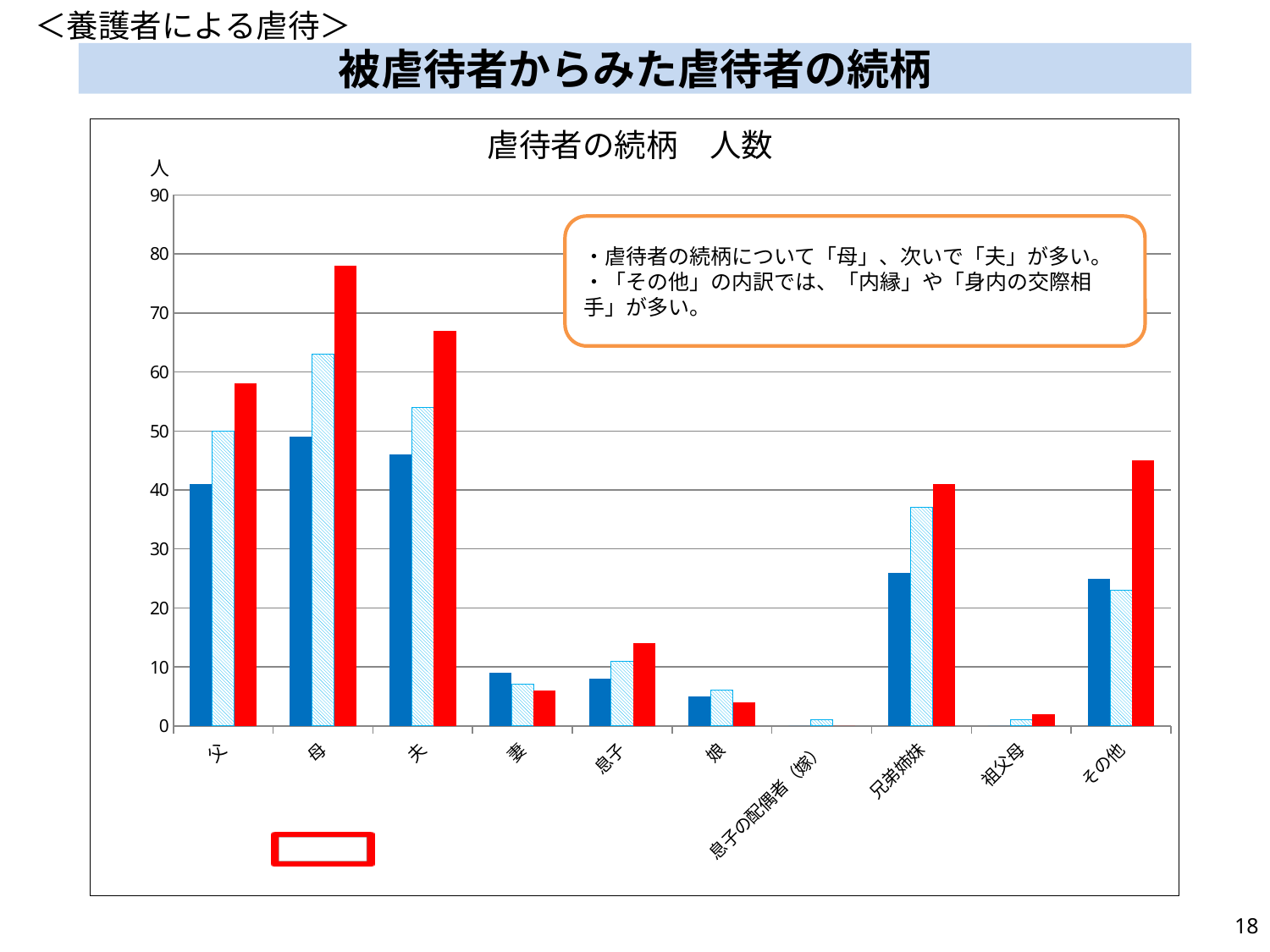
Which has the larger red bar, 父 or 夫? 夫 How many categories are shown on the x axis of the chart? 10 What kind of chart is shown on the slide? bar chart Is the red bar for 夫 greater or less than 60? greater What unit label is shown at the top of the vertical axis? 人 What is the title of the chart? 虐待者の続柄 人数 Which category has the tallest light blue hatched bar? 母 Which has the larger red bar, 息子 or 娘? 息子 Is the dark blue bar for 兄弟姉妹 greater or less than 30? less Is the dark blue bar for 父 greater or less than 50? less Which category has the tallest red bar? 母